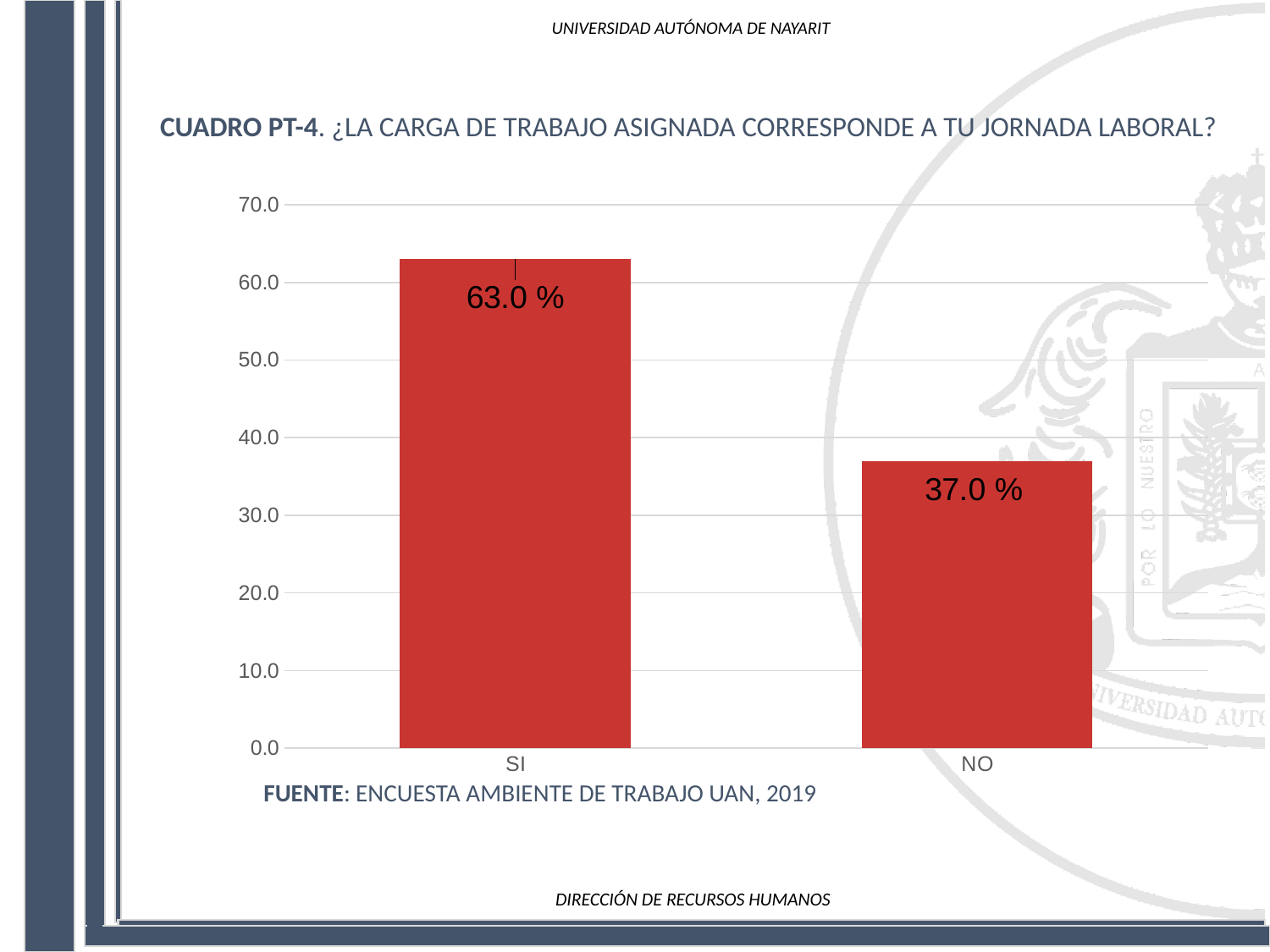
Which category has the highest value? SI Is the value for NO greater or less than 40.0? less Which is larger, the value for SI or the value for NO? SI How many categories are shown on the x axis? 2 What is the difference between the values for SI and NO? 26.0 % Which category has the lowest value? NO Is the value for SI greater or less than 60.0? greater What is the value for NO? 37.0 % What is the total of the values for SI and NO? 100.0 % What is the value for SI? 63.0 % What source is cited below the chart? ENCUESTA AMBIENTE DE TRABAJO UAN, 2019 What kind of chart is shown on the slide? bar chart